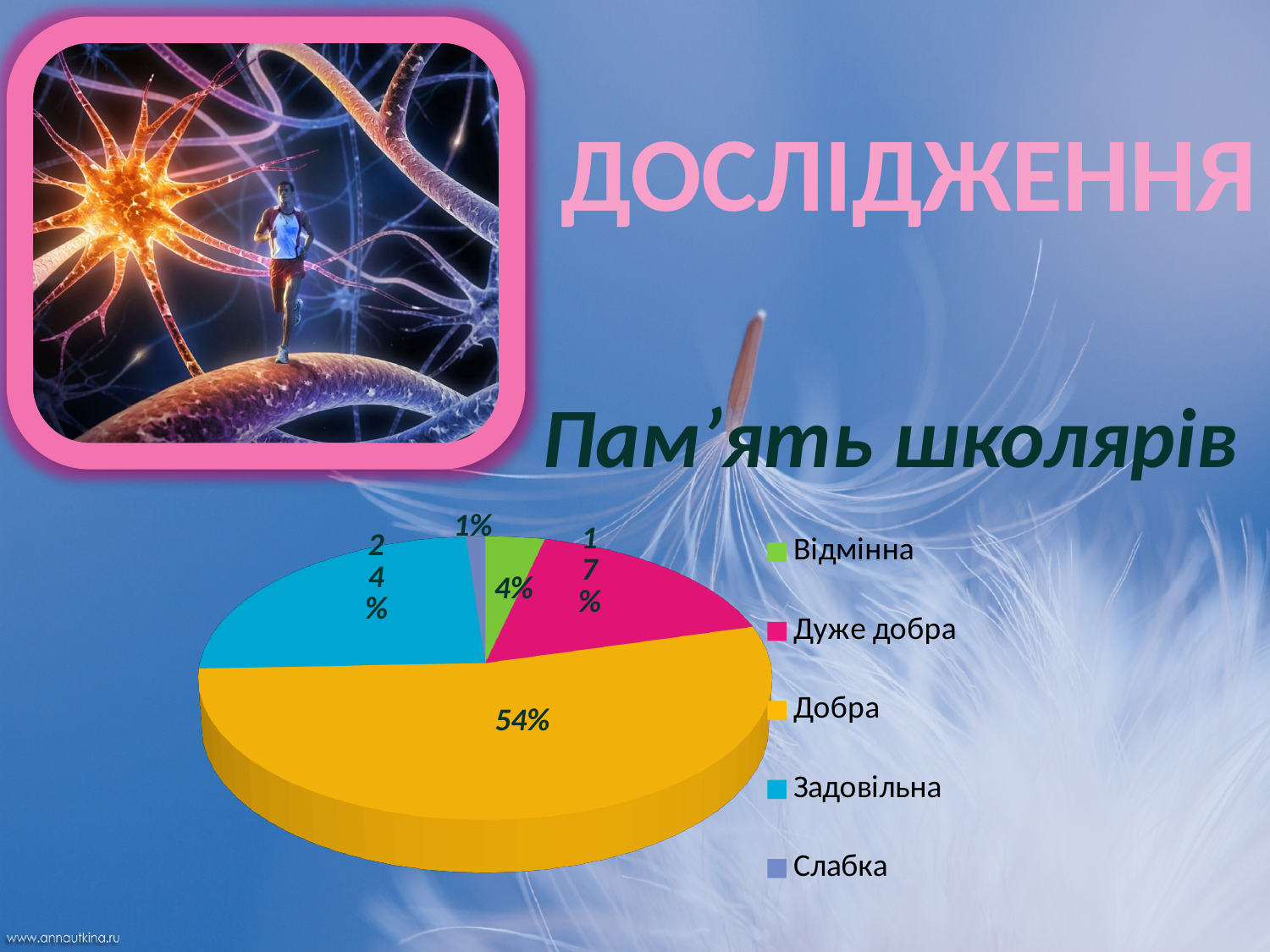
What is the title of the chart? Пам’ять школярів Which category has the smallest slice of the pie? Слабка What is the value for "Відмінна"? 4% Which is larger, the value for "Дуже добра" or the value for "Задовільна"? Задовільна What share of the pie does "Добра" take? 54% What is the value for "Дуже добра"? 17% How many categories does the pie chart have? 5 What is the difference between the values for "Добра" and "Задовільна"? 30% What is the value for "Слабка"? 1% What is the value for "Задовільна"? 24% What kind of chart is shown on the slide? pie chart Which category has the largest slice of the pie? Добра